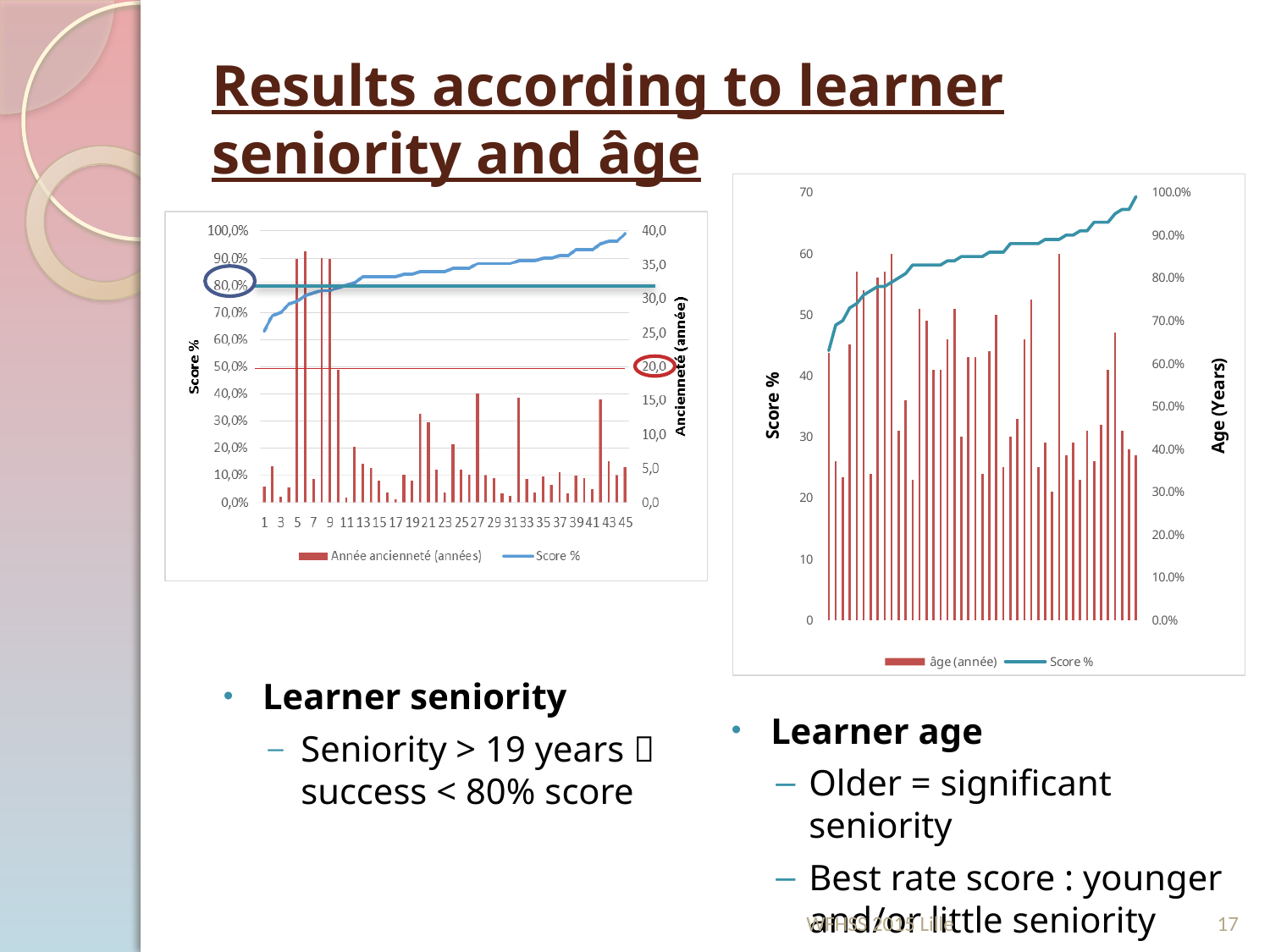
In the left chart, is the Score % value for category 1 greater or less than 70,0%? less In the right chart, does the Score % line rise or fall from left to right along the x axis? Rises How many series does the legend of the left chart list? 2 What kind of chart is the left chart (seniority)? Combined bar and line chart How many series does the legend of the right chart list? 2 In the left chart, is the Année ancienneté bar for category 5 greater or less than 30,0 years? greater In the left chart, does the Score % line rise or fall from left to right along the x axis? Rises In the left chart, what is the highest category number shown on the x axis? 45 What is the title of the right-hand vertical axis of the right chart? Age (Years) What are the two legend entries of the right chart? âge (année) and Score % In the left chart, is the Score % value for category 45 greater or less than 90,0%? greater What kind of chart is the right chart (age)? Combined bar and line chart